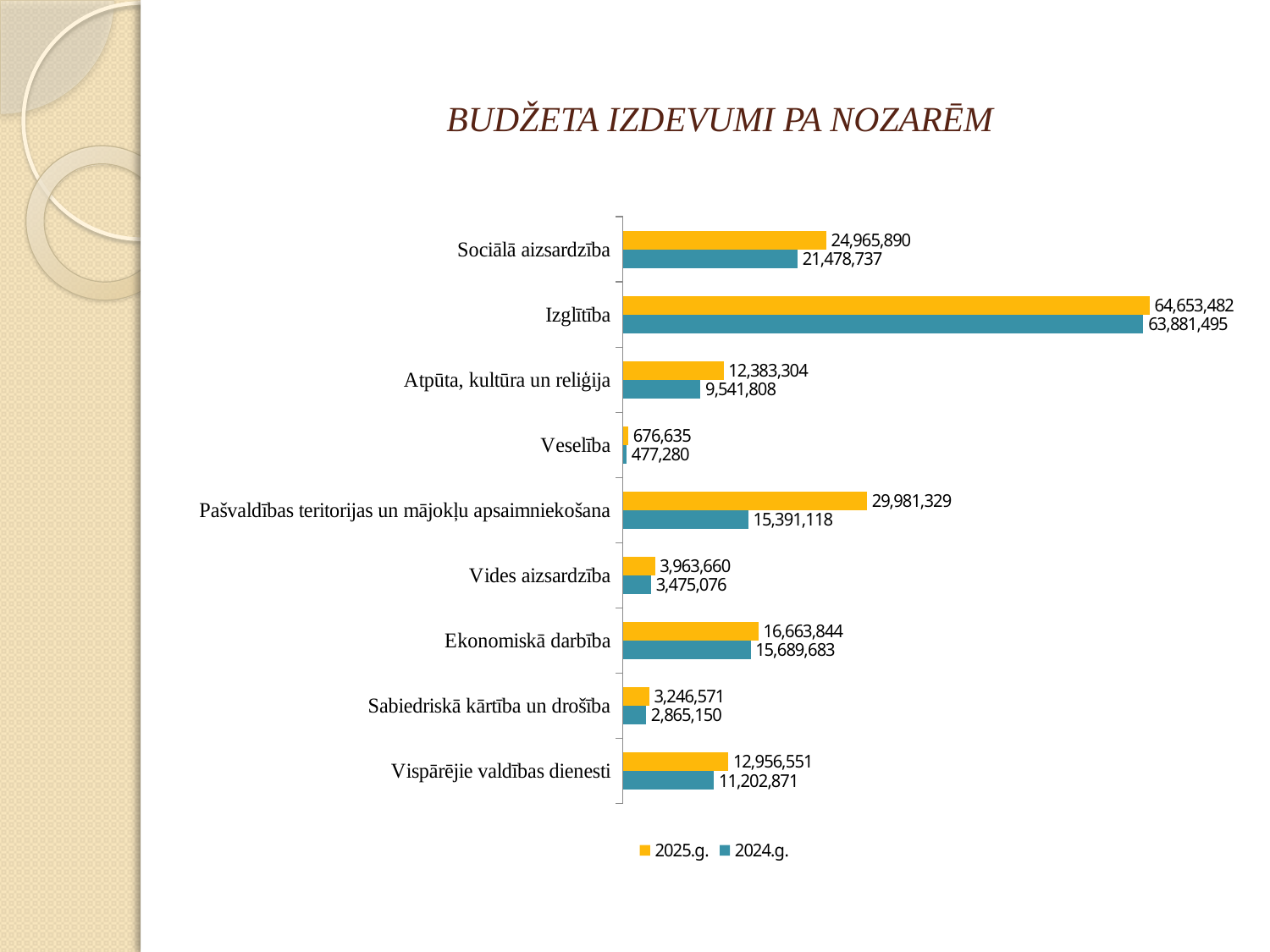
What is the 2024.g. value for Vispārējie valdības dienesti? 11,202,871 What is the difference between the 2025.g. and 2024.g. values for Pašvaldības teritorijas un mājokļu apsaimniekošana? 14,590,211 What kind of chart is shown on the slide? Bar chart What is the difference between the 2025.g. and 2024.g. values for Sociālā aizsardzība? 3,487,153 What is the 2025.g. value for Pašvaldības teritorijas un mājokļu apsaimniekošana? 29,981,329 Which is larger: the 2025.g. value for Ekonomiskā darbība or the 2025.g. value for Atpūta, kultūra un reliģija? Ekonomiskā darbība How many categories are shown in the chart? 9 How many series does the legend list? 2 What is the 2025.g. value for Izglītība? 64,653,482 Which category has the lowest 2024.g. value? Veselība Which category has the highest 2025.g. value? Izglītība What is the 2024.g. value for Sociālā aizsardzība? 21,478,737